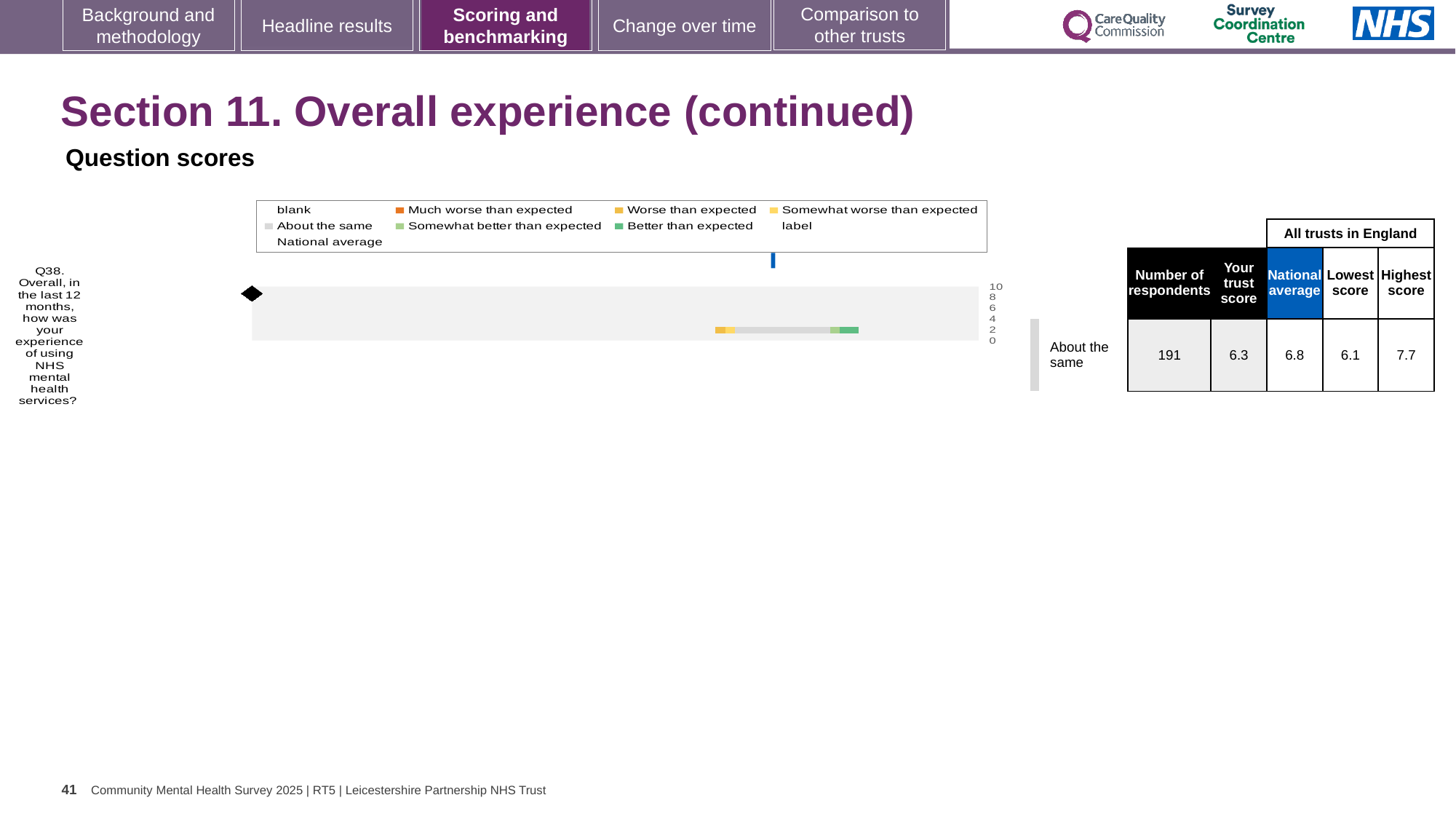
Which benchmarking category is Q38 placed in? About the same What is the lowest score among all trusts in England for Q38? 6.1 What is the highest score among all trusts in England for Q38? 7.7 What is the national average score for Q38? 6.8 What is the trust's score for Q38 (Overall, in the last 12 months, how was your experience of using NHS mental health services?)? 6.3 Which is larger for Q38: the trust's score or the national average? National average How many survey questions are plotted on the chart? 1 What is the highest value shown on the chart's score axis? 10 How many respondents answered Q38? 191 What is the difference between the highest and lowest trust scores for Q38? 1.6 What kind of chart is shown for Q38? bar chart What is the difference between the national average and the trust's score for Q38? 0.5